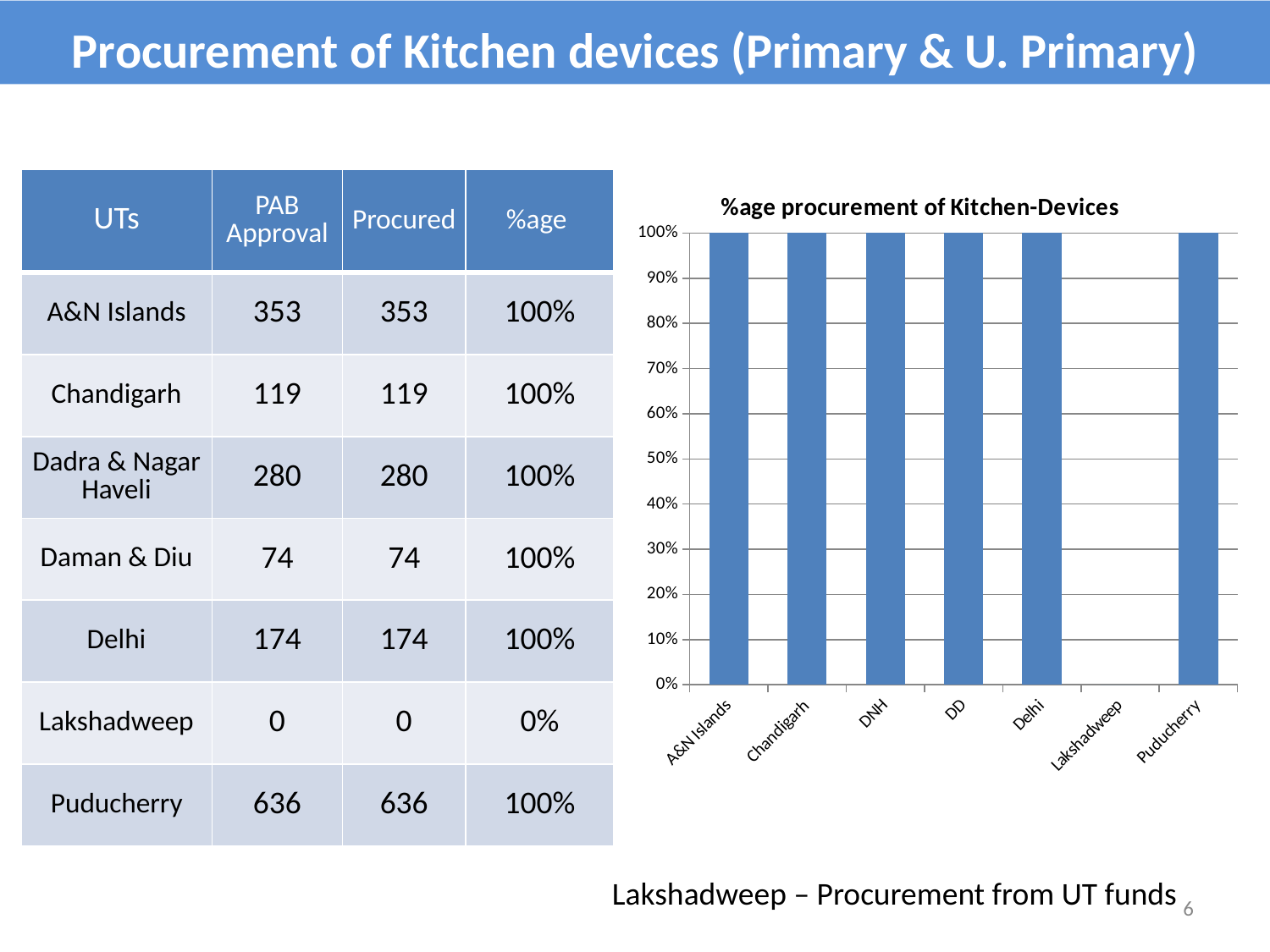
Is the value for Lakshadweep greater or less than 10%? less What is the highest value shown on the y axis of the chart? 100% What kind of chart is shown on the slide? bar chart What is the difference between the value for A&N Islands and the value for Lakshadweep? 100% What is the value for DNH in the chart? 100% What is the value for Puducherry in the chart? 100% What is the title of the chart? %age procurement of Kitchen-Devices How many UTs are shown on the x axis of the chart? 7 Which UT has the lowest value in the chart? Lakshadweep Is the value for Delhi greater or less than 50%? greater What is the value for Lakshadweep in the chart? 0% Which is larger, the value for Chandigarh or the value for Lakshadweep? Chandigarh